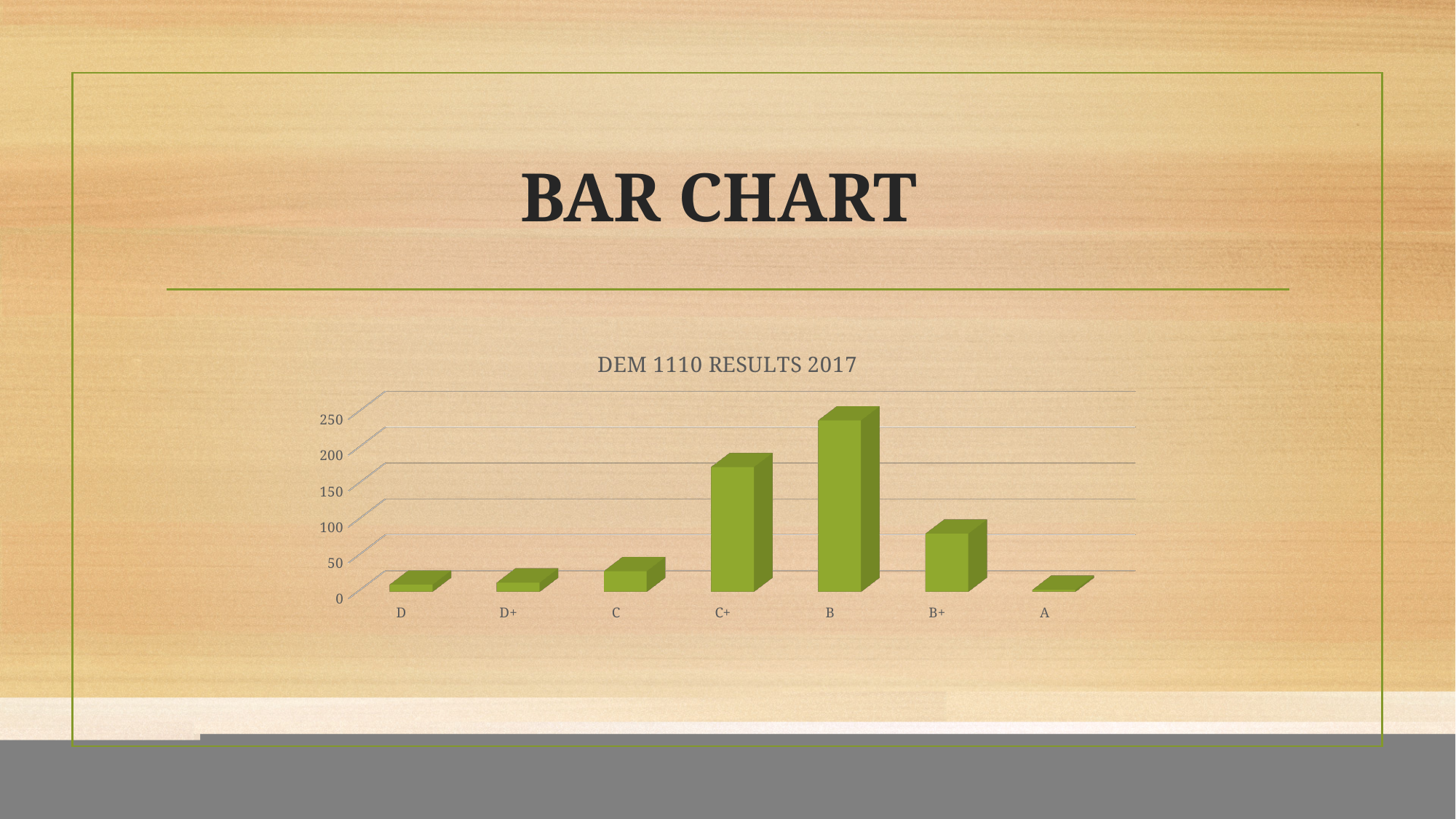
Which is larger, the value for C+ or the value for B+? C+ What type of chart is shown on the slide? bar chart Is the value for C+ greater or less than 150? greater What is the title of the chart? DEM 1110 RESULTS 2017 Which grade category has the highest value? B Is the value for D greater or less than 50? less Is the value for B greater or less than 200? greater How many grade categories are shown on the x axis? 7 What colour are the bars in the chart? green Which is larger, the value for B or the value for C+? B